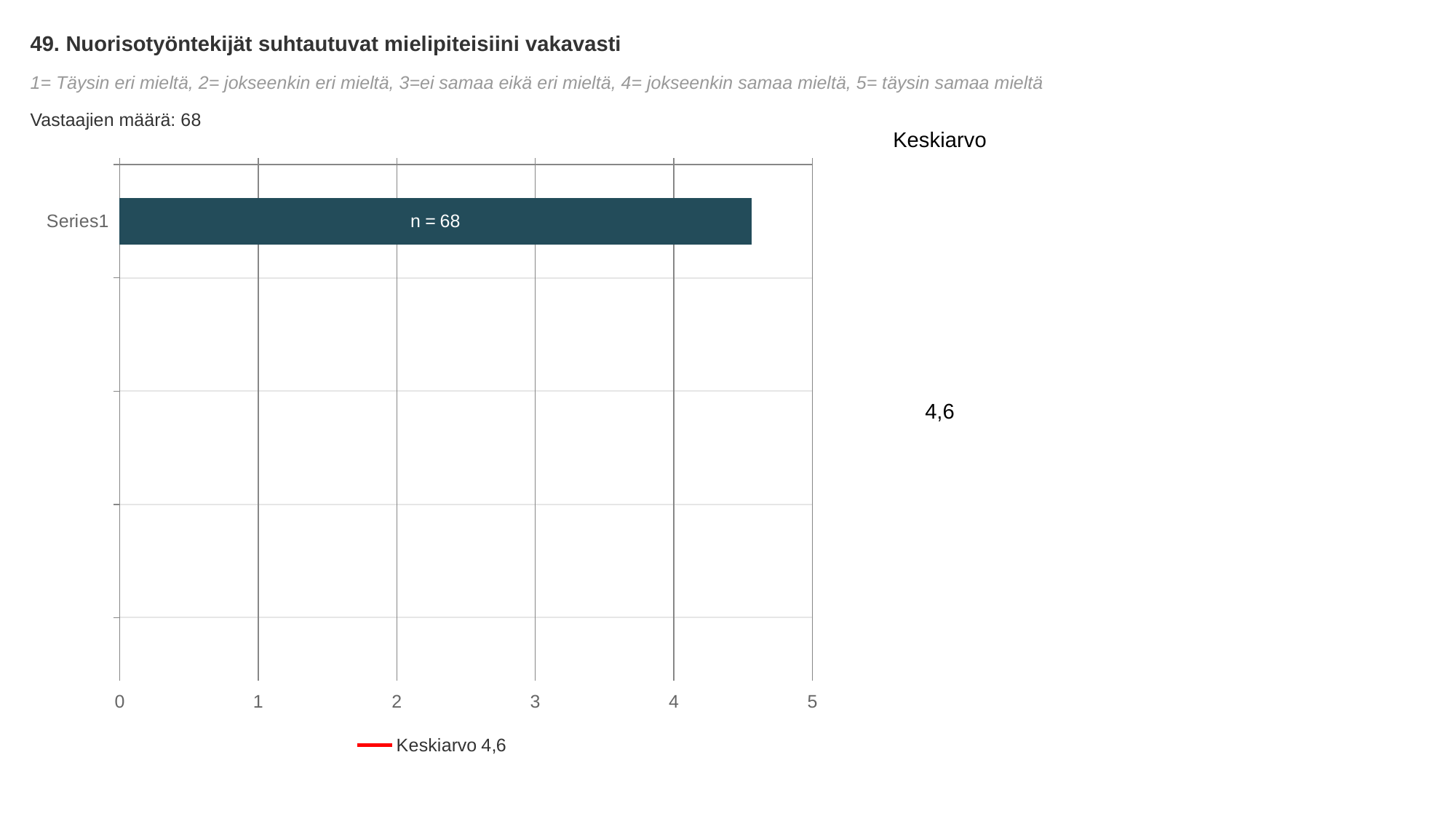
What does the legend entry below the chart say? Keskiarvo 4,6 Is the value of the Series1 bar greater or less than 5? less How many bars are plotted in the chart? 1 What is the number of respondents (Vastaajien määrä) stated on the slide? 68 Is the value of the Series1 bar greater or less than 4? greater What kind of chart is shown on the slide? bar chart What is the highest value shown on the x axis? 5 What data label is printed on the Series1 bar? n = 68 What is the Keskiarvo (mean) value shown on the slide? 4,6 What is the category label of the single bar? Series1